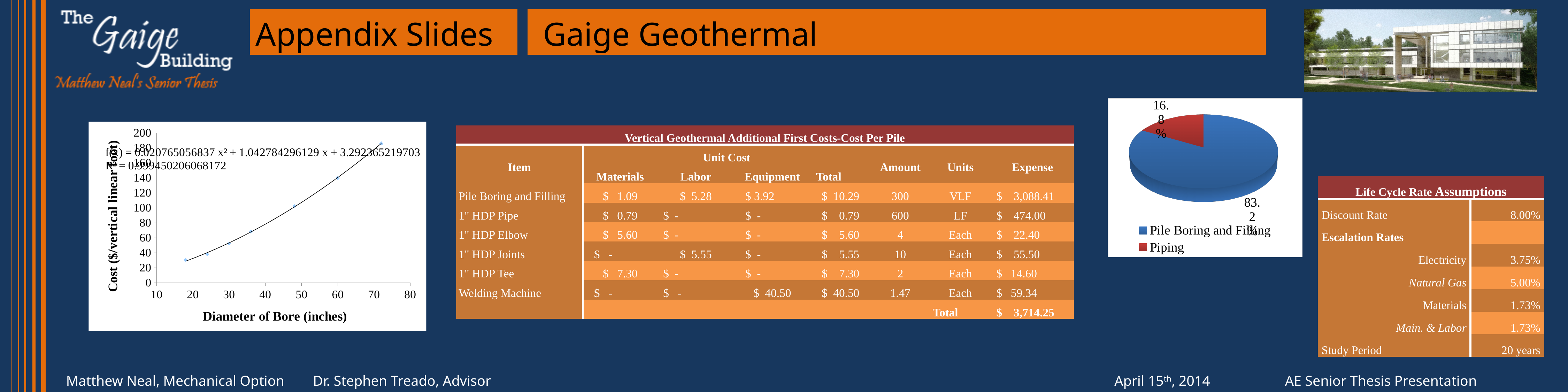
What is the x-axis title of the chart on the left? Diameter of Bore (inches) In the pie chart, what is the difference in percentage points between the Pile Boring and Filling share and the Piping share? 66.4% How many entries does the legend of the pie chart list? 2 In the pie chart, which slice is the smallest? Piping In the pie chart, what colour is the Piping slice? Red In the pie chart, what share does Piping account for? 16.8% What kind of chart is the chart on the right side of the slide with the legend entries Pile Boring and Filling and Piping? Pie chart In the pie chart, what share does Pile Boring and Filling account for? 83.2% In the pie chart, which slice is the largest? Pile Boring and Filling What kind of chart is the chart on the left of the slide plotting cost against diameter of bore? Scatter chart In the chart on the left, does the cost rise or fall as the diameter of bore increases? Rise In the chart on the left, is the cost at a bore diameter of 72 inches greater or less than 160? greater